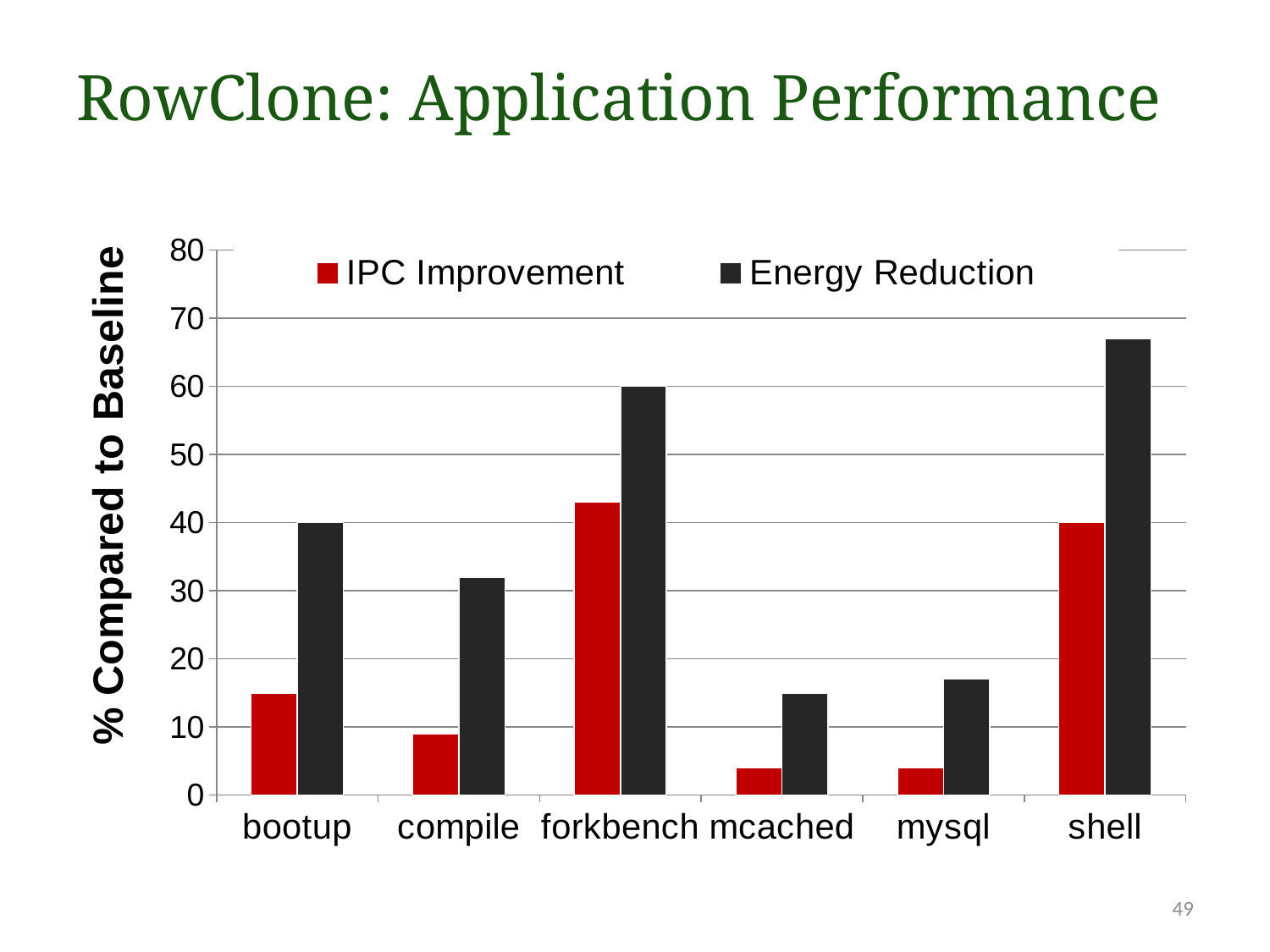
Is the Energy Reduction for mysql greater or less than 20? less How many series does the legend list? 2 What is the label on the y axis? % Compared to Baseline Is the IPC Improvement for mcached greater or less than 10? less What kind of chart is shown on the slide? bar chart Is the Energy Reduction for shell greater or less than 60? greater Which application has the highest IPC Improvement? forkbench Which is larger: the Energy Reduction for bootup or the Energy Reduction for compile? bootup Which is larger: the Energy Reduction for forkbench or the Energy Reduction for shell? shell Which application has the highest Energy Reduction? shell How many applications are shown on the x axis? 6